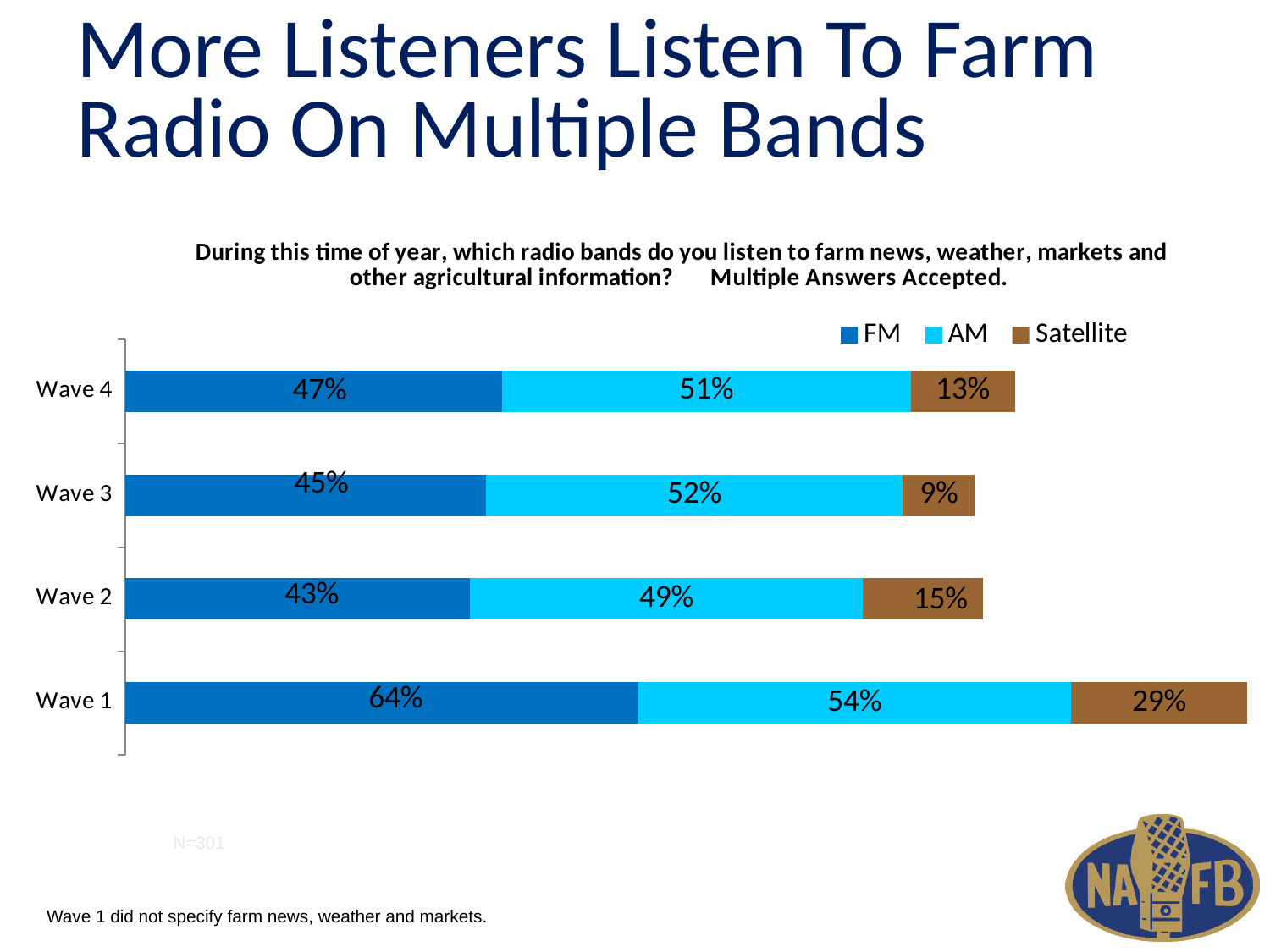
Which wave has the highest FM value? Wave 1 What is the AM value for Wave 3? 52% How many series does the legend list? 3 What is the Satellite value for Wave 1? 29% What is the total of the stacked bar for Wave 3? 106% What is the Satellite value for Wave 2? 15% Which wave has the lowest Satellite value? Wave 3 What is the FM value for Wave 4? 47% Which is larger, the AM value for Wave 4 or the AM value for Wave 2? Wave 4 What is the difference between the FM values for Wave 1 and Wave 2? 21% What kind of chart is shown on the slide? Stacked bar chart How many waves are shown on the chart? 4